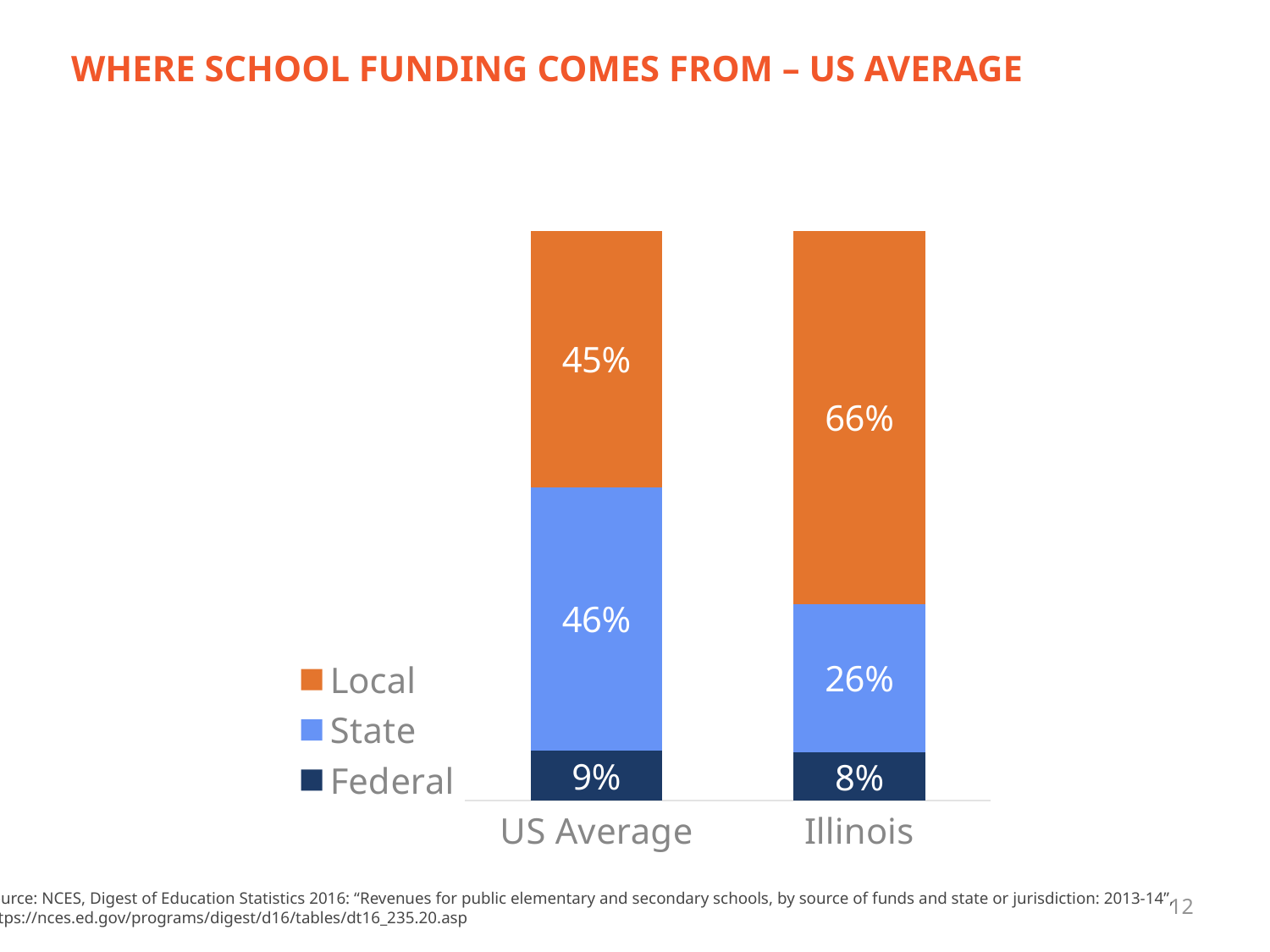
What kind of chart is shown on the slide? Stacked bar chart How many categories are shown on the x axis? 2 Which funding source is the largest for Illinois? Local What share of school funding comes from Local sources in Illinois? 66% What share of school funding comes from Federal sources for the US Average? 9% Which funding source is the smallest for the US Average? Federal What share of school funding comes from State sources in Illinois? 26% What share of school funding comes from Local sources for the US Average? 45% How many series does the legend list? 3 What colour represents the Local series in the chart? Orange Which has a larger State share, the US Average or Illinois? US Average How many percentage points higher is the Local share in Illinois than for the US Average? 21